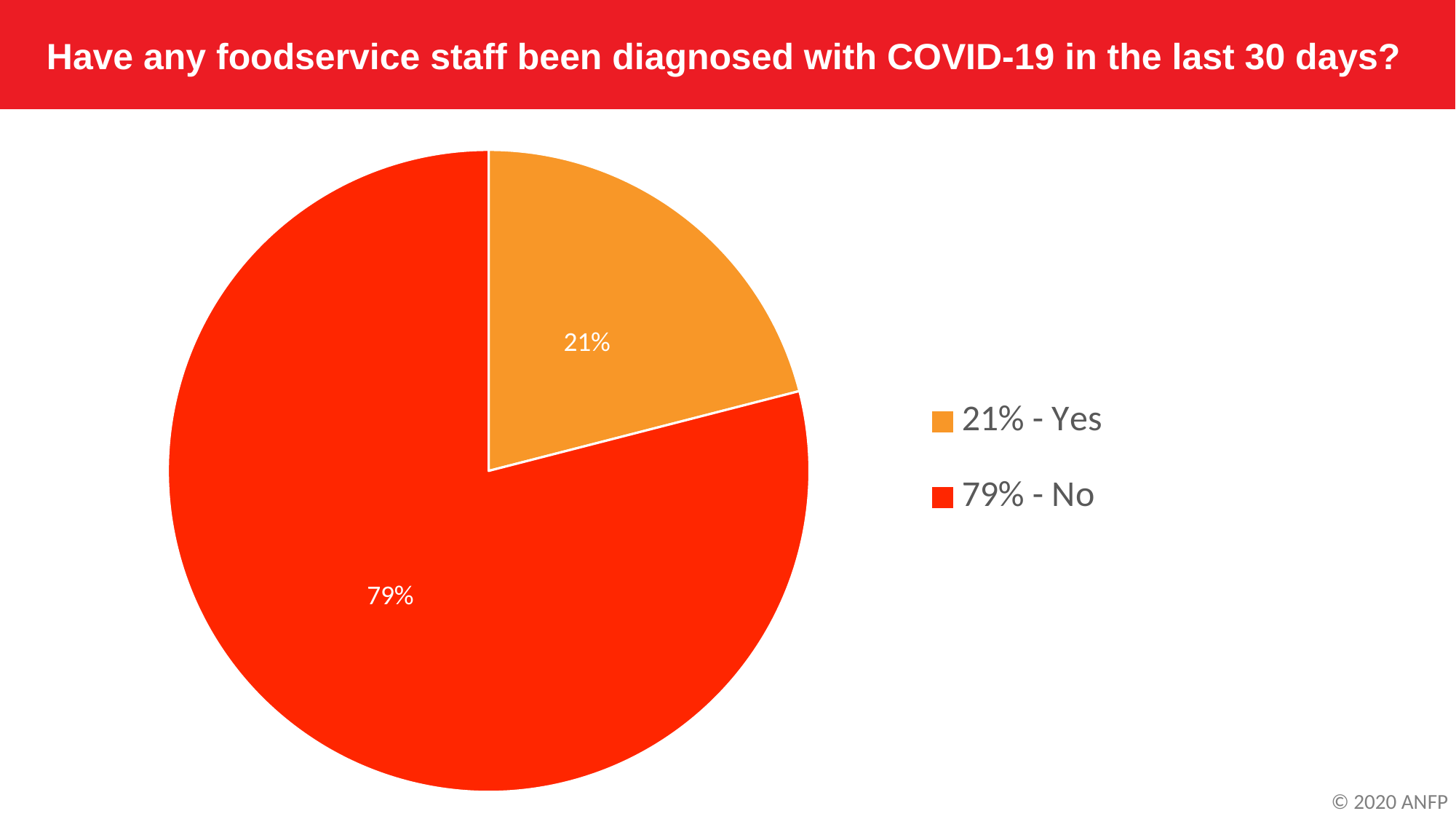
Which is larger, the Yes slice or the No slice? No What colour is the No slice? red Which response has the smallest share of the pie? Yes What is the difference in percentage points between the No and Yes slices? 58 How many slices does the pie chart have? 2 Which response has the largest share of the pie? No What percentage of respondents answered Yes? 21% What share of the pie does the Yes slice represent? 21% What is the title of the chart? Have any foodservice staff been diagnosed with COVID-19 in the last 30 days? What percentage of respondents answered No? 79% How many entries does the legend list? 2 What kind of chart is shown on the slide? pie chart